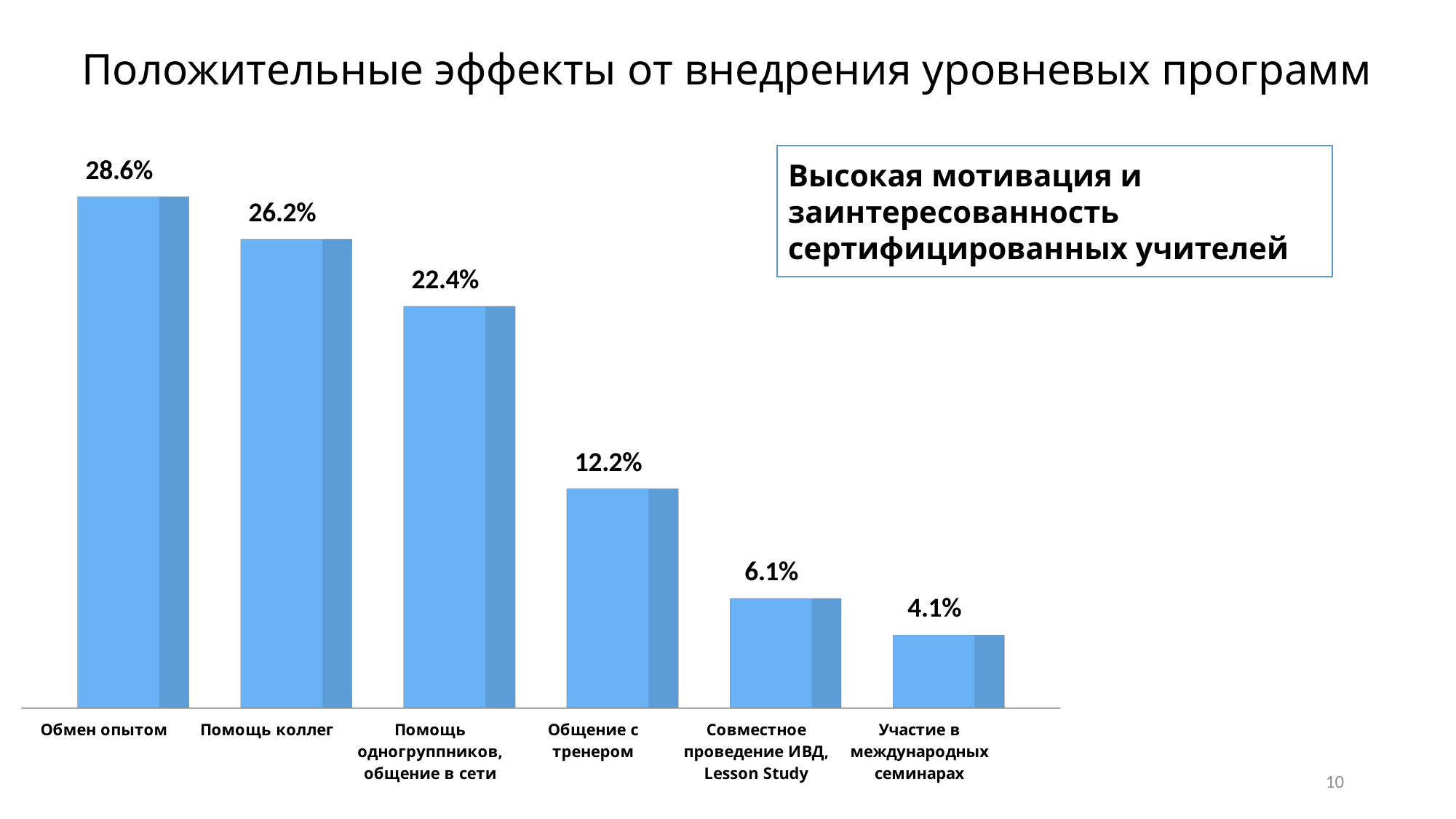
Which category has the lowest value? Участие в международных семинарах How many categories are shown in the chart? 6 Do the values rise or fall from left to right along the x axis? Fall What is the value for Общение с тренером? 12.2% What is the value for Совместное проведение ИВД, Lesson Study? 6.1% What is the value for Обмен опытом? 28.6% What is the difference between the values for Помощь одногруппников, общение в сети and Общение с тренером? 10.2% What is the difference between the values for Обмен опытом and Помощь коллег? 2.4% What kind of chart is shown on the slide? Bar chart Which is larger, the value for Помощь коллег or the value for Помощь одногруппников, общение в сети? Помощь коллег Which category has the highest value? Обмен опытом What is the value for Участие в международных семинарах? 4.1%